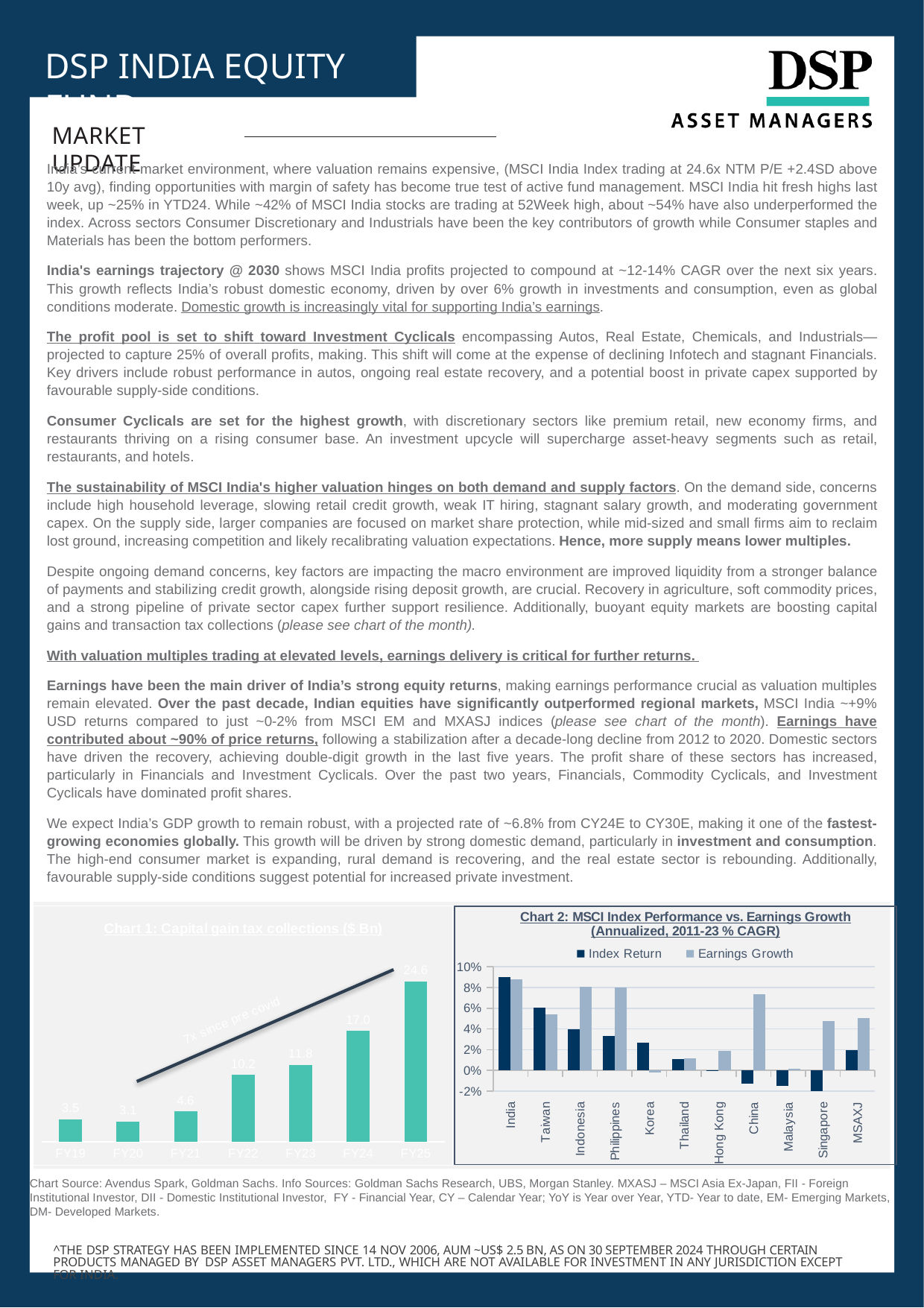
In Chart 1 (Capital gain tax collections), what is the difference between the FY25 and FY24 values? 7.6 In Chart 1 (Capital gain tax collections), which financial year has the highest value? FY25 In Chart 2 (MSCI Index Performance vs. Earnings Growth), is the Index Return for India greater or less than 8%? greater In Chart 1 (Capital gain tax collections), what is the value for FY25? 24.6 In Chart 1 (Capital gain tax collections), which financial year has the lowest value? FY20 In Chart 1 (Capital gain tax collections), do the values generally rise or fall from FY19 to FY25? rise In Chart 2 (MSCI Index Performance vs. Earnings Growth), which is larger for China: Index Return or Earnings Growth? Earnings Growth In Chart 2 (MSCI Index Performance vs. Earnings Growth), which market has the highest Index Return? India How many financial years are shown in Chart 1 (Capital gain tax collections)? 7 What kind of chart is Chart 2 (MSCI Index Performance vs. Earnings Growth)? bar chart In Chart 1 (Capital gain tax collections), what is the value for FY22? 10.2 How many series does the legend of Chart 2 (MSCI Index Performance vs. Earnings Growth) list? 2